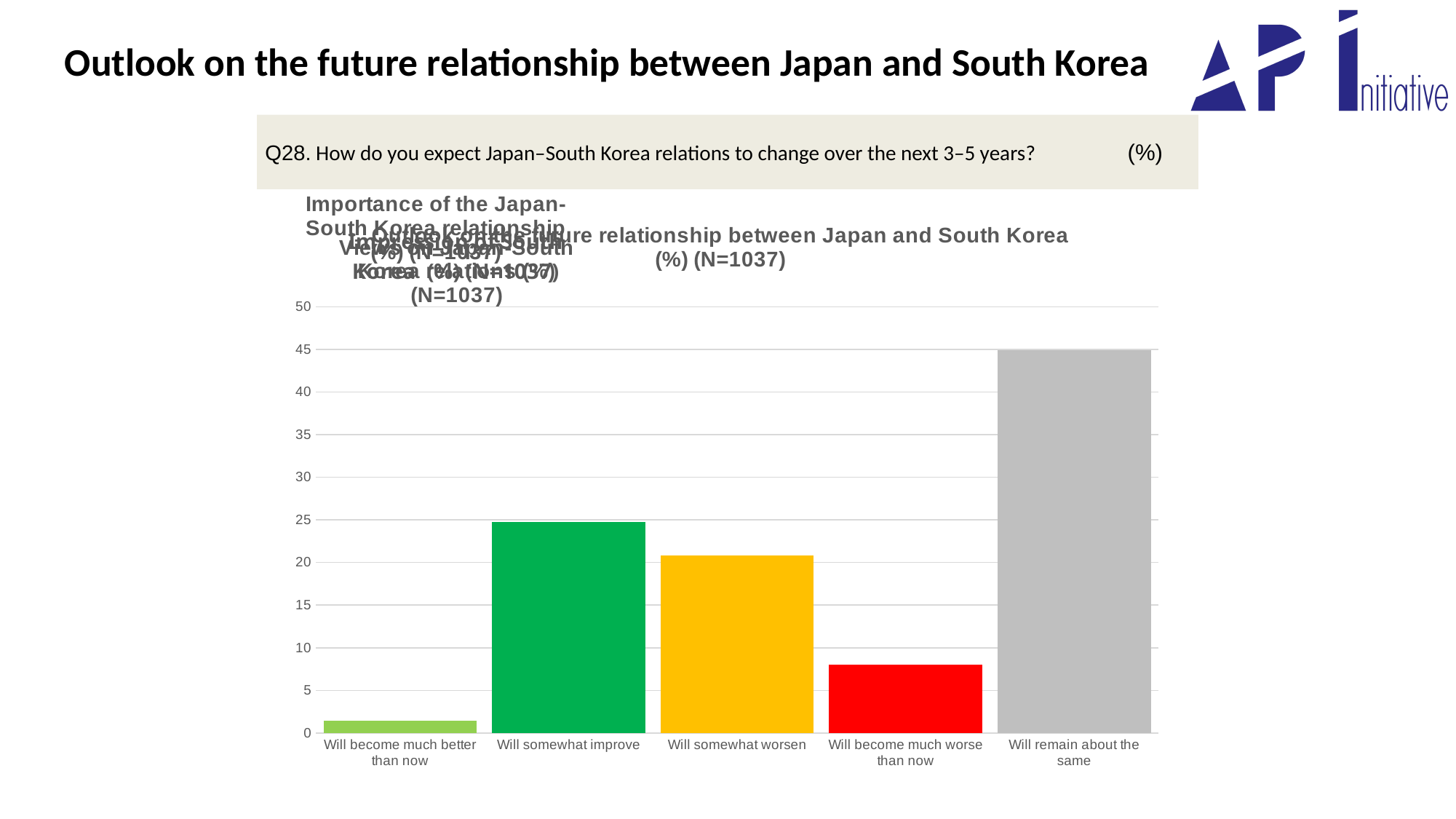
Which is larger, the value for "Will become much worse than now" or the value for "Will become much better than now"? Will become much worse than now Is the value for "Will somewhat improve" greater or less than 20? greater Is the value for "Will remain about the same" greater or less than 40? greater What is the sample size (N) stated in the chart title? N=1037 What kind of chart is shown on the slide? bar chart Is the value for "Will become much better than now" greater or less than 5? less What colour is the bar for "Will become much worse than now"? red Which category has the lowest value in the chart? Will become much better than now Which is larger, the value for "Will somewhat improve" or the value for "Will somewhat worsen"? Will somewhat improve Which category has the highest value in the chart? Will remain about the same How many categories are shown on the x axis of the chart? 5